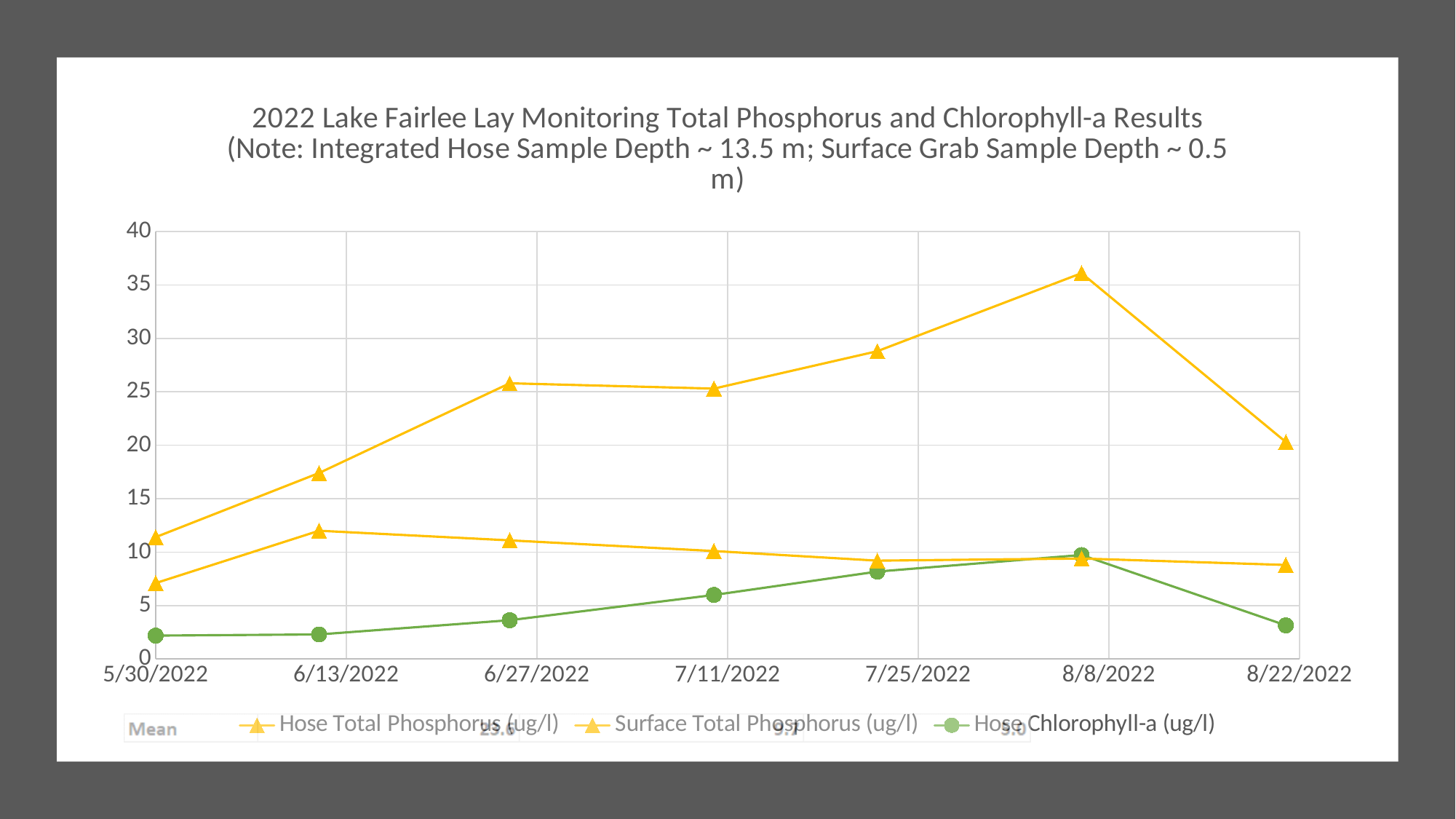
On which date is Hose Chlorophyll-a (ug/l) highest? 8/8/2022 Is the value for Hose Total Phosphorus (ug/l) on 8/8/2022 greater or less than 30? greater What kind of chart is shown on the slide? line chart How many series does the legend list? 3 On which date is Surface Total Phosphorus (ug/l) lowest? 5/30/2022 Which series is plotted with green circle markers? Hose Chlorophyll-a (ug/l) Is the value for Hose Chlorophyll-a (ug/l) on 5/30/2022 greater or less than 5? less On which date is Hose Total Phosphorus (ug/l) lowest? 5/30/2022 How many sampling dates are plotted along the x axis? 7 Which is larger on 7/25/2022: Hose Total Phosphorus (ug/l) or Surface Total Phosphorus (ug/l)? Hose Total Phosphorus (ug/l) On which date is Hose Total Phosphorus (ug/l) highest? 8/8/2022 Does Hose Total Phosphorus (ug/l) rise or fall from 5/30/2022 to 6/27/2022? rise